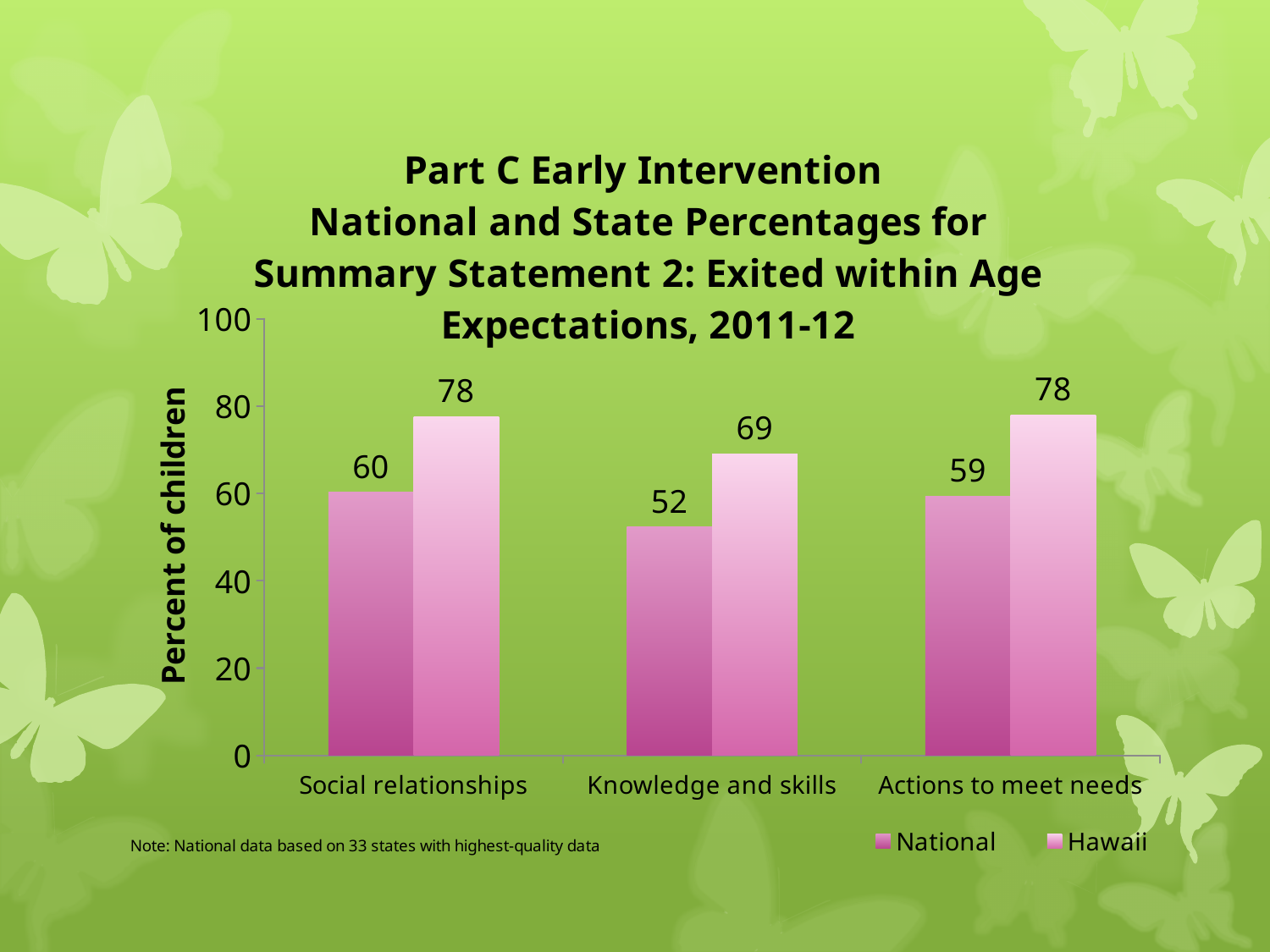
What is the label of the vertical axis? Percent of children What is the difference between the Hawaii and National values for Social relationships? 18 Which category has the lowest Hawaii value? Knowledge and skills Which is larger for Actions to meet needs, the National value or the Hawaii value? Hawaii What is the difference between the Hawaii and National values for Knowledge and skills? 17 Which category has the lowest National value? Knowledge and skills How many series does the legend list? 2 What is the National value for Actions to meet needs? 59 What kind of chart is shown on the slide? Bar chart What is the National value for Social relationships? 60 How many categories are shown on the x axis? 3 What is the Hawaii value for Knowledge and skills? 69